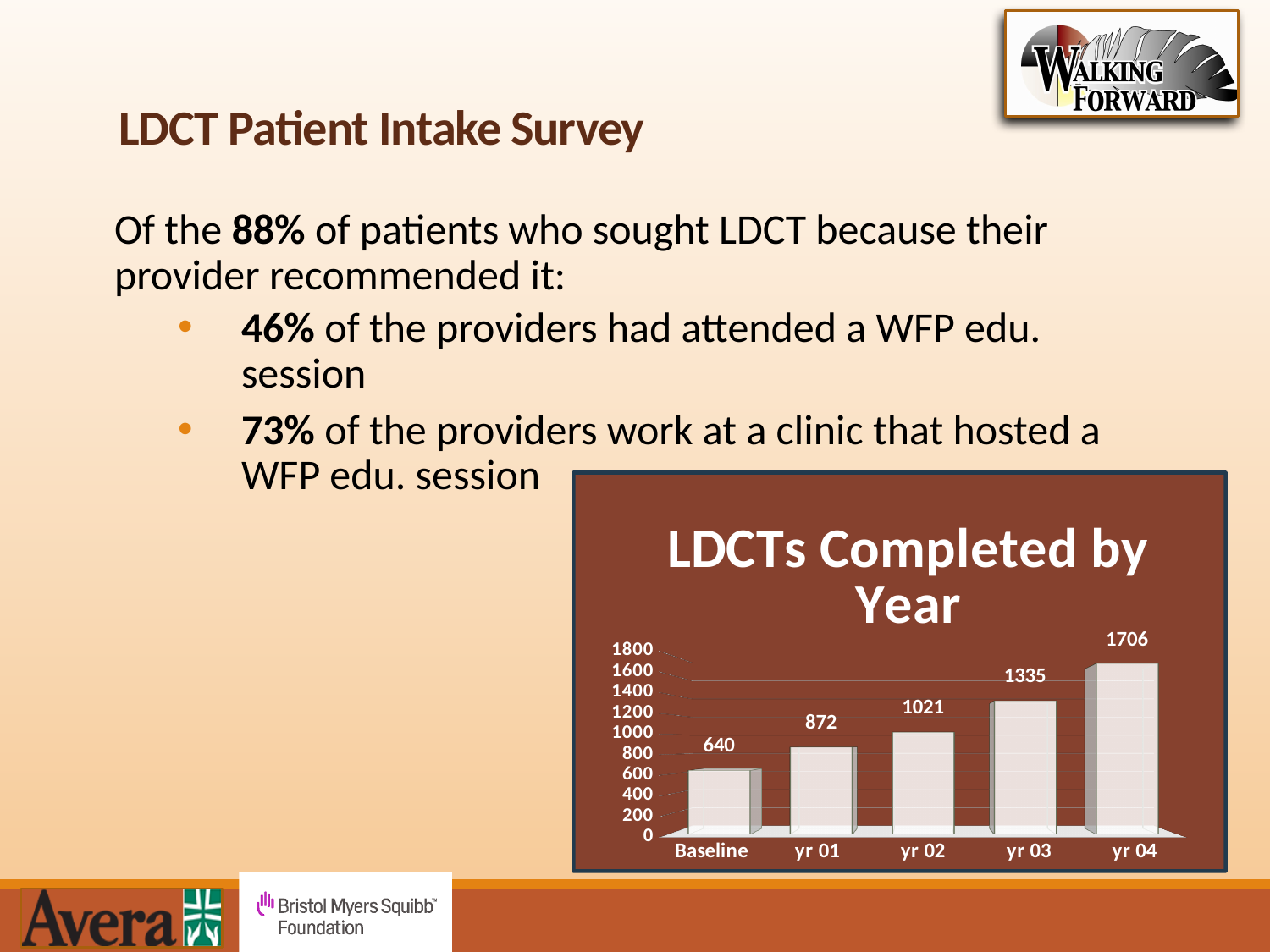
Is the value for yr 03 greater or less than 1200? greater How many LDCTs were completed in yr 02? 1021 What is the difference between the LDCTs completed in yr 01 and Baseline? 232 How many categories are shown on the x axis of the chart? 5 Which is larger, the value for yr 02 or the value for yr 01? yr 02 Which year has the highest number of LDCTs completed? yr 04 What kind of chart is shown on the slide? bar chart What is the difference between the LDCTs completed in yr 04 and yr 03? 371 How many LDCTs were completed in yr 04? 1706 Which category has the lowest number of LDCTs completed? Baseline What is the value for Baseline in the LDCTs Completed by Year chart? 640 Do the values rise or fall from Baseline to yr 04? rise